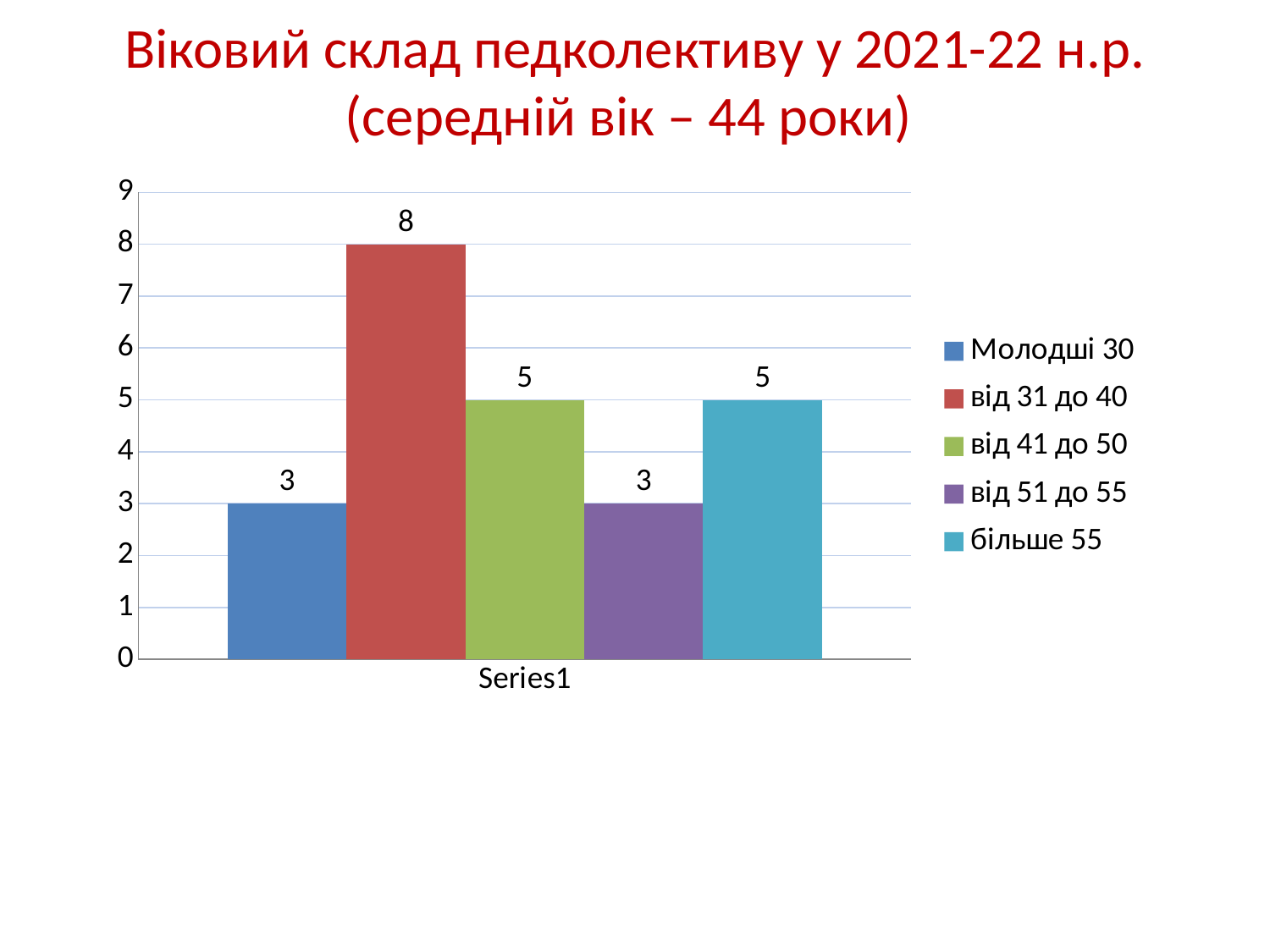
What is the total of all the bar values in the chart? 24 What is the value for the 'від 31 до 40' age group? 8 What is the difference between the values for 'від 31 до 40' and 'від 41 до 50'? 3 What kind of chart is shown on the slide? bar chart How many age groups are shown in the legend? 5 What is the label shown on the x axis below the bars? Series1 What is the value for the 'більше 55' age group? 5 Which is larger: the value for 'від 41 до 50' or the value for 'від 51 до 55'? від 41 до 50 What colour is the bar for 'від 31 до 40'? red How many bars are plotted in the chart? 5 What is the value for the 'Молодші 30' age group? 3 Which age group has the highest value? від 31 до 40